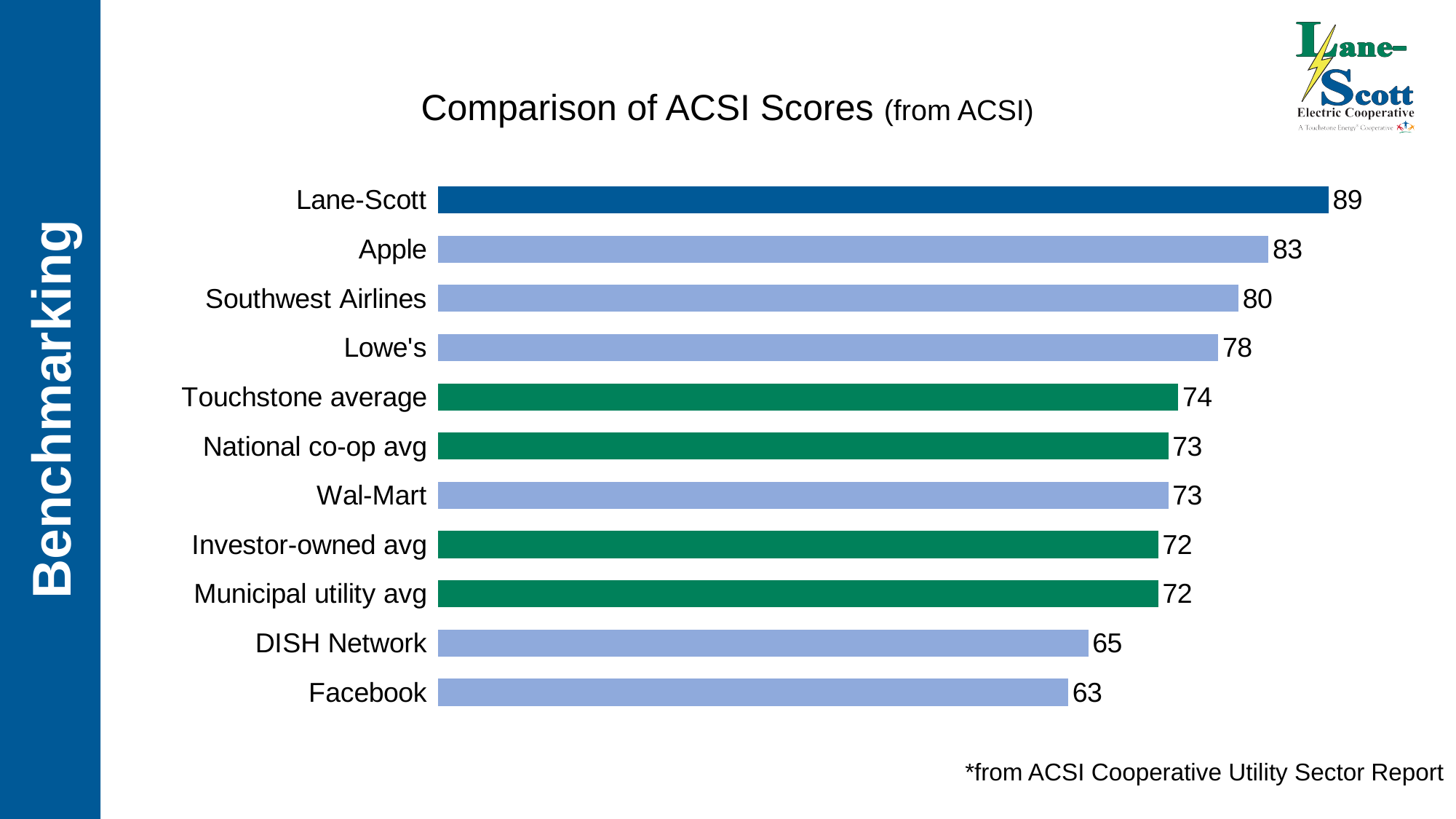
What is the title of the chart? Comparison of ACSI Scores (from ACSI) What is the difference between the ACSI scores of Lane-Scott and Apple? 6 Which category has the lowest ACSI score? Facebook What kind of chart is shown on the slide? Bar chart Which category has the highest ACSI score? Lane-Scott What is the ACSI score for Southwest Airlines? 80 How many categories are shown in the chart? 11 Which has a higher ACSI score, Apple or Lowe's? Apple What is the ACSI score for the Touchstone average? 74 What is the ACSI score for DISH Network? 65 What is the ACSI score for Lane-Scott? 89 What is the difference between the ACSI scores of Lowe's and Facebook? 15